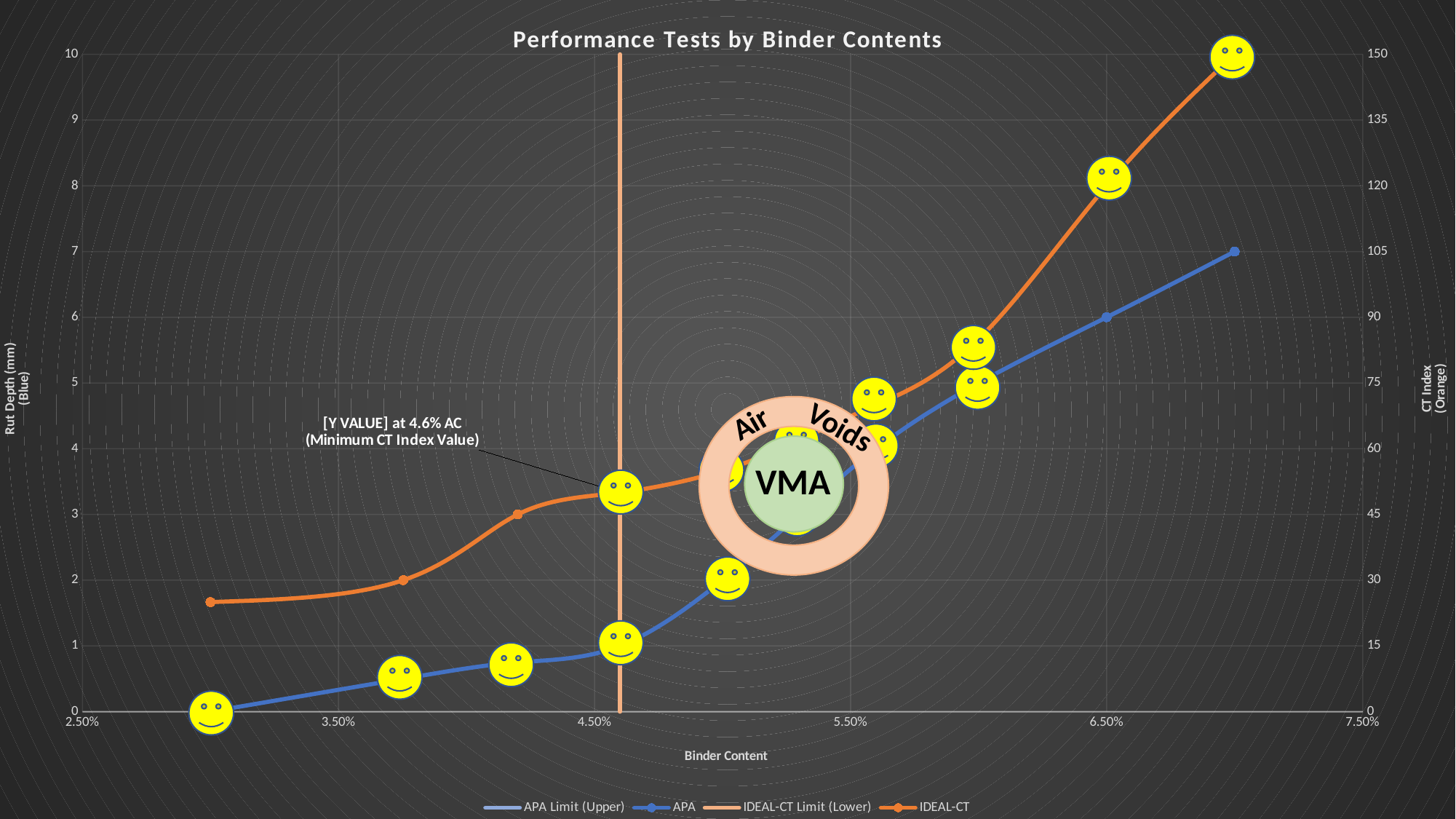
What is the title of the chart? Performance Tests by Binder Contents How many series does the legend list? 4 Which has the higher IDEAL-CT value, 3.50% or 6.50% binder content? 6.50% What kind of chart is shown on the slide? line chart Which has the higher APA rut depth, 4.50% or 5.50% binder content? 5.50% Does the APA series rise or fall as binder content increases? rise What is the label of the x axis? Binder Content Is the IDEAL-CT value at 6.50% binder content greater or less than 105? greater Is the IDEAL-CT value at 3.50% binder content greater or less than 45? less Is the APA rut depth at 6.50% binder content greater or less than 5 mm? greater Does the IDEAL-CT series rise or fall as binder content increases? rise